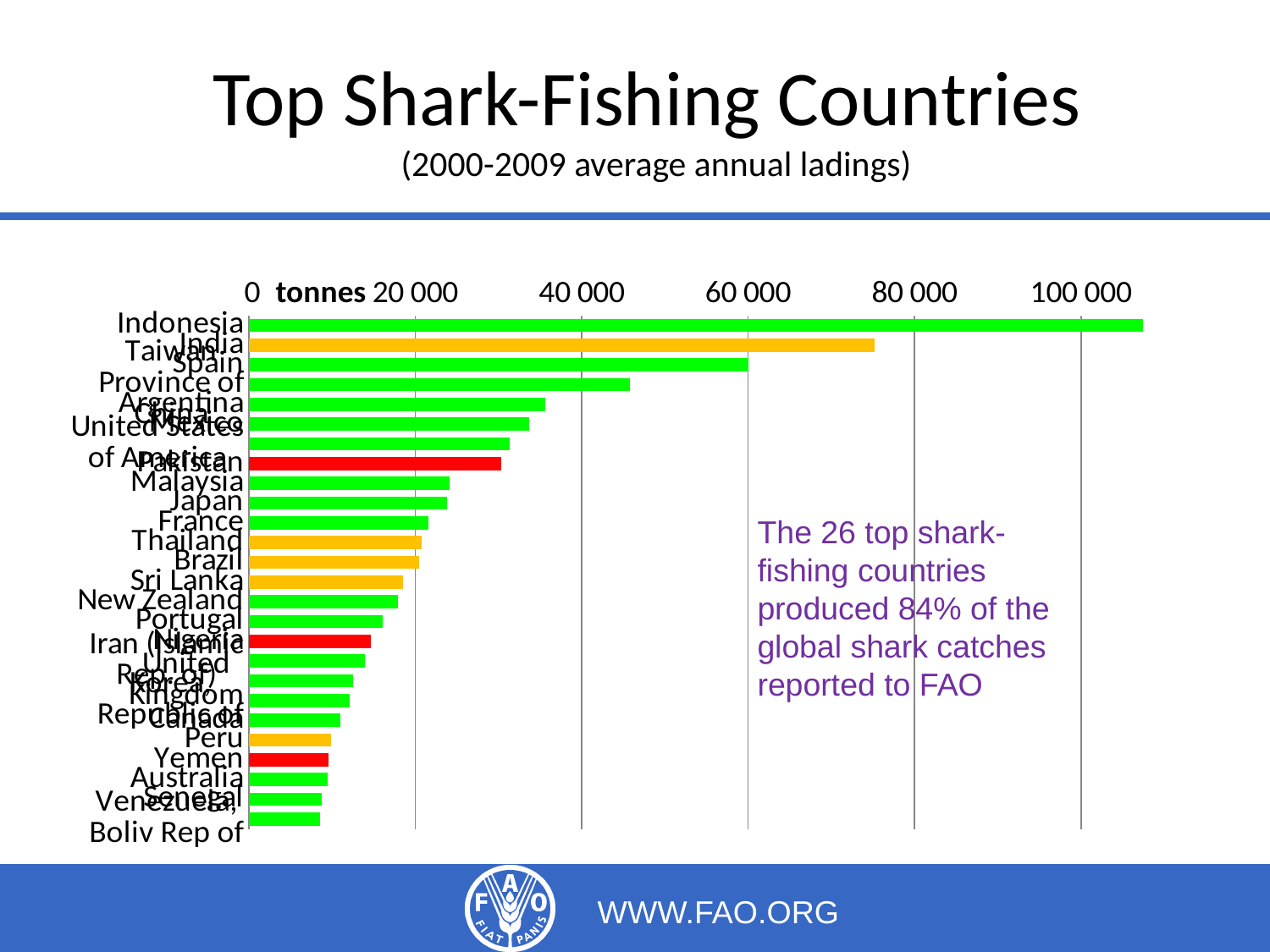
Which has the larger value, India or Spain? India What unit is shown on the value axis of the chart? tonnes What kind of chart is shown on the slide? bar chart Which has the larger value, Pakistan or Malaysia? Pakistan How many countries are plotted in the chart? 26 Is the value for Sri Lanka greater or less than 20 000 tonnes? less Which country has the highest average annual landings in the chart? Indonesia Is the value for India greater or less than 60 000 tonnes? greater Is the value for Indonesia greater or less than 100 000 tonnes? greater According to the text on the chart, what share of global shark catches reported to FAO did the 26 top countries produce? 84%